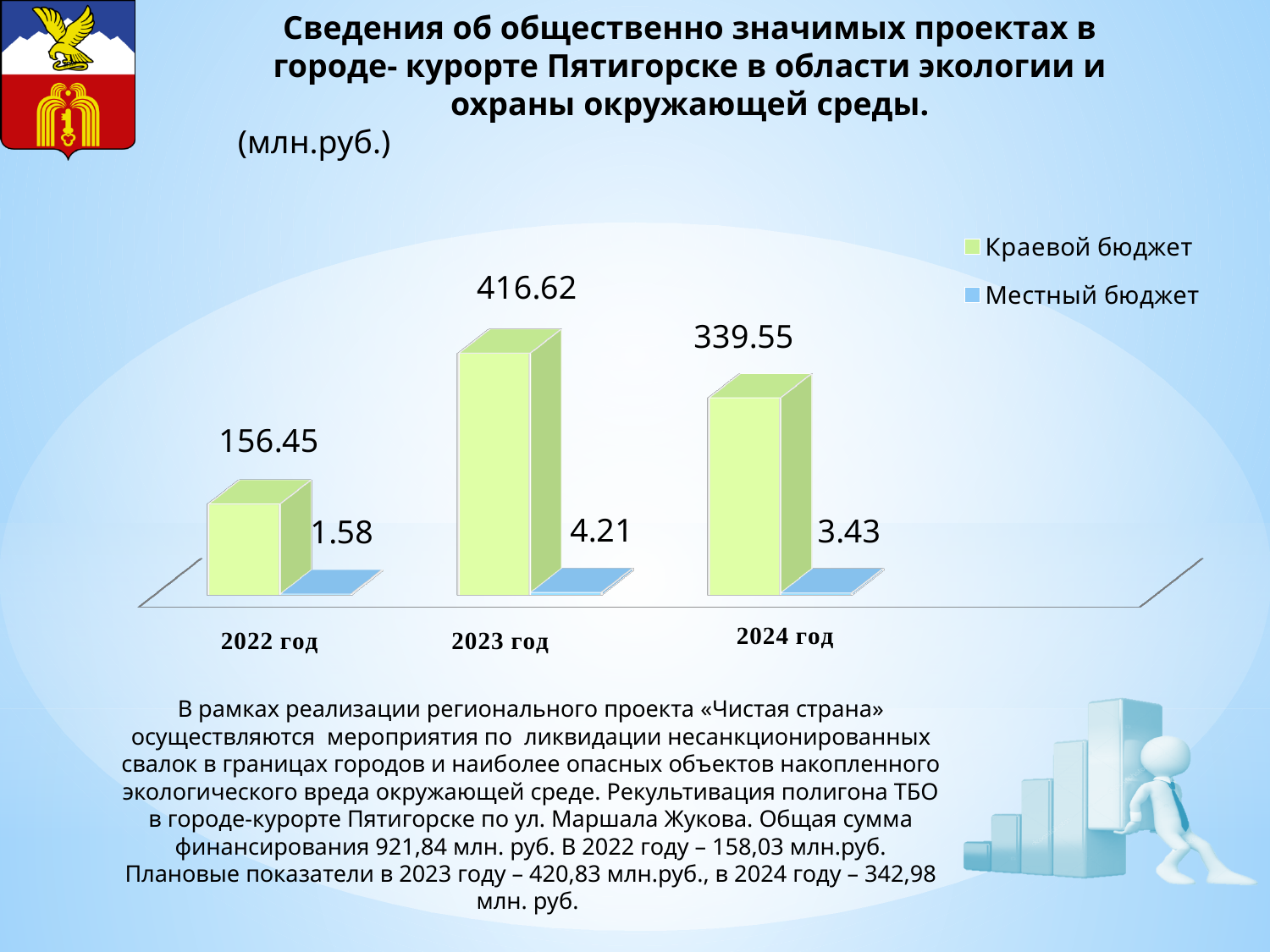
In which year is Местный бюджет the lowest? 2022 год What is the value of Местный бюджет for 2022 год? 1.58 How many series does the legend list? 2 What is the value of Местный бюджет for 2024 год? 3.43 What is the difference between Краевой бюджет in 2023 год and 2022 год? 260.17 Which legend entry is shown in green? Краевой бюджет How many years are shown on the x axis? 3 Which is larger: Местный бюджет in 2023 год or in 2024 год? 2023 год What is the value of Краевой бюджет for 2023 год? 416.62 What is the value of Краевой бюджет for 2024 год? 339.55 What kind of chart is shown on the slide? Bar chart In which year is Краевой бюджет the highest? 2023 год